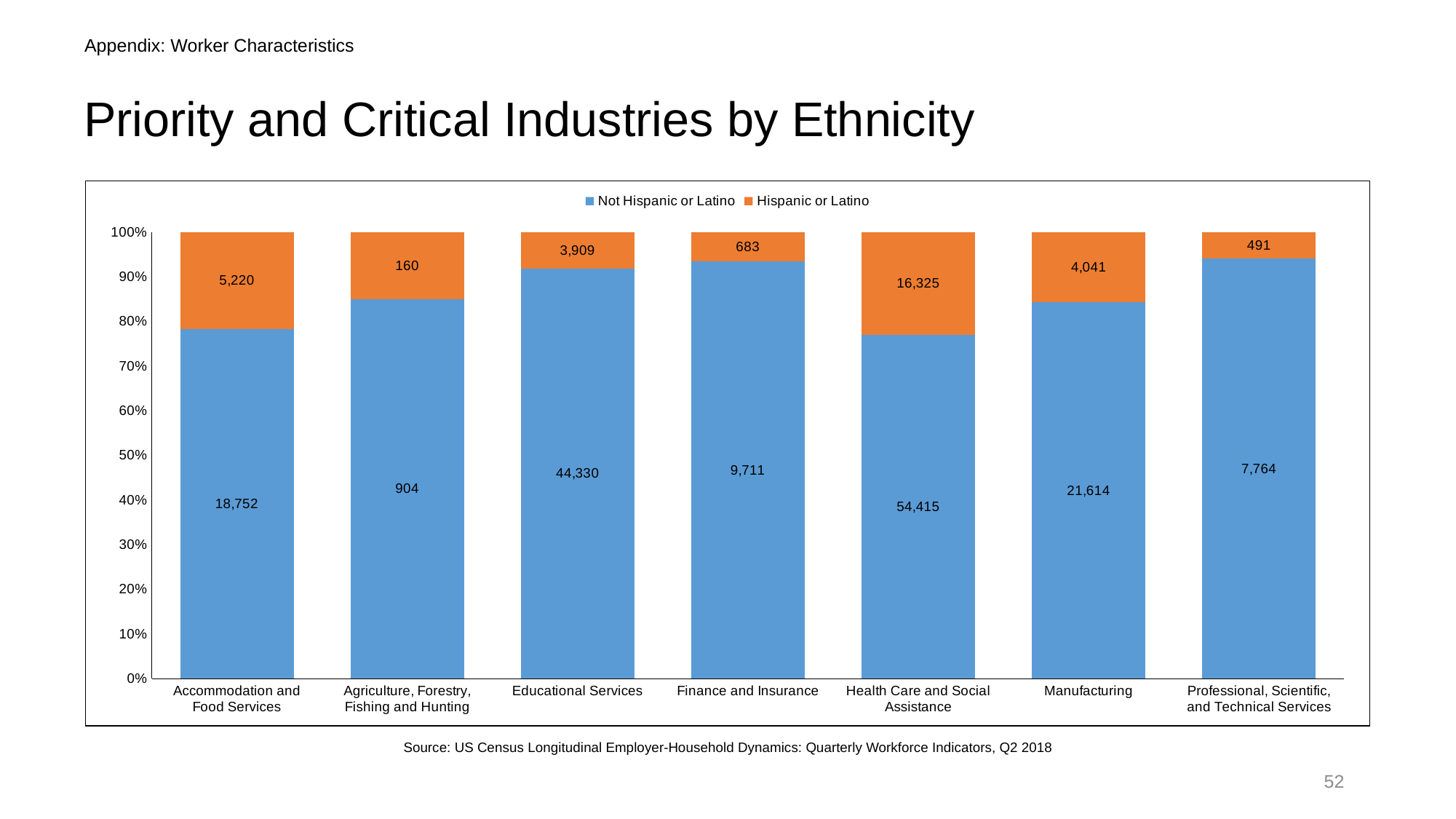
How many series does the legend list? 2 What is the Hispanic or Latino value for Manufacturing? 4,041 Which is larger: the Hispanic or Latino value for Educational Services or for Manufacturing? Manufacturing What kind of chart is shown on the slide? Stacked bar chart What is the total of the Finance and Insurance bar (Not Hispanic or Latino plus Hispanic or Latino)? 10,394 What is the Hispanic or Latino value for Accommodation and Food Services? 5,220 What is the Not Hispanic or Latino value for Health Care and Social Assistance? 54,415 What is the difference between the Not Hispanic or Latino and Hispanic or Latino values for Manufacturing? 17,573 Which industry has the lowest Not Hispanic or Latino value? Agriculture, Forestry, Fishing and Hunting Is the Not Hispanic or Latino share of the Health Care and Social Assistance bar greater or less than 80%? less How many industries are shown on the x axis? 7 Which industry has the highest Hispanic or Latino value? Health Care and Social Assistance